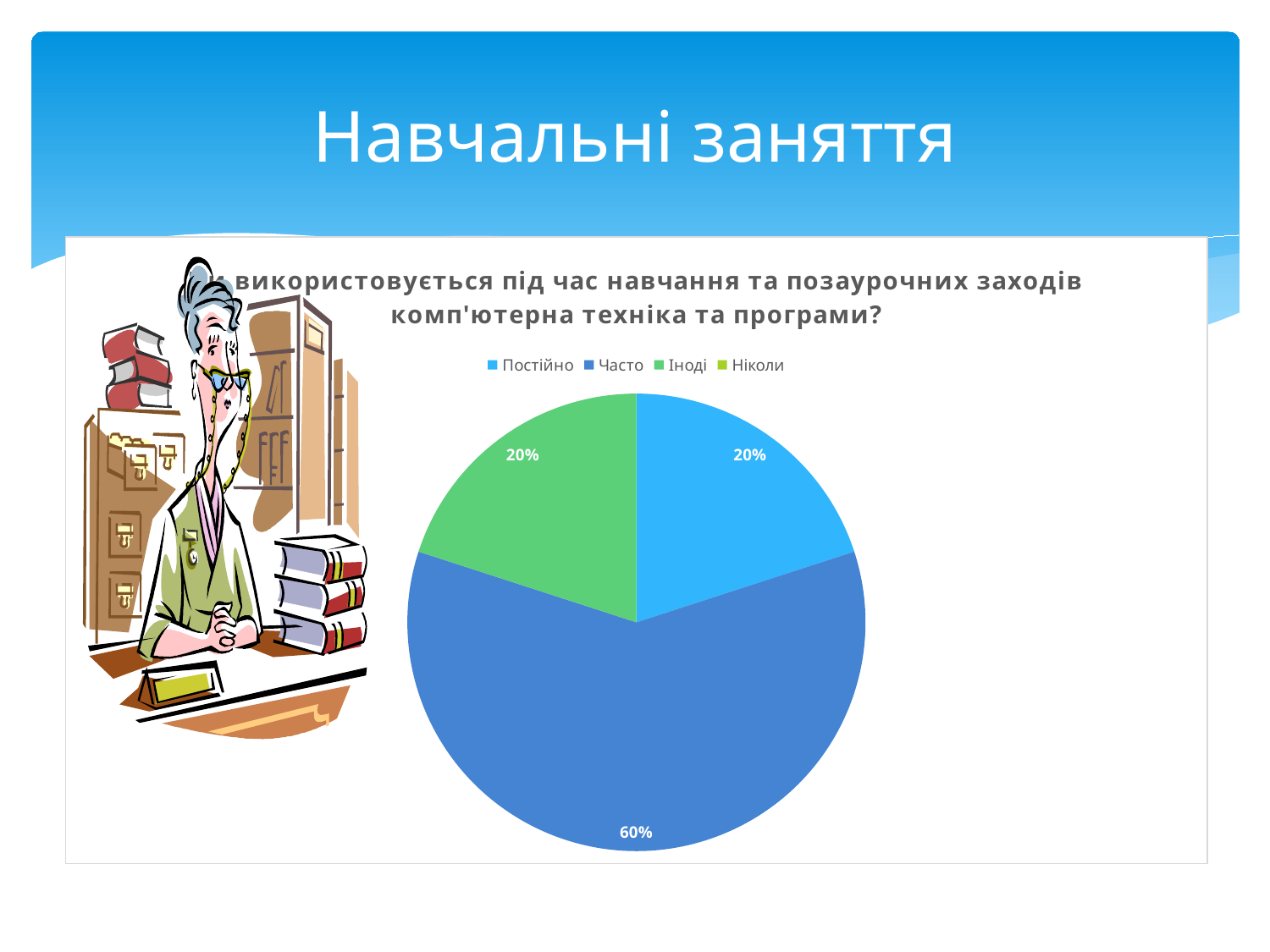
How many entries does the chart legend list? 4 What kind of chart is shown on the slide? Pie chart What share of the pie does the "Постійно" slice represent? 20% What share of the pie does the "Часто" slice represent? 60% Is the share for "Часто" greater or less than 50%? greater How many slices are visible in the pie chart? 3 What is the difference in percentage points between the "Часто" slice and the "Постійно" slice? 40% Which category has the largest slice of the pie? Часто What colour is the "Іноді" slice in the pie chart? Green What share of the pie does the "Іноді" slice represent? 20% Which legend entry is listed first in the chart legend? Постійно Which slice is larger, "Часто" or "Іноді"? Часто